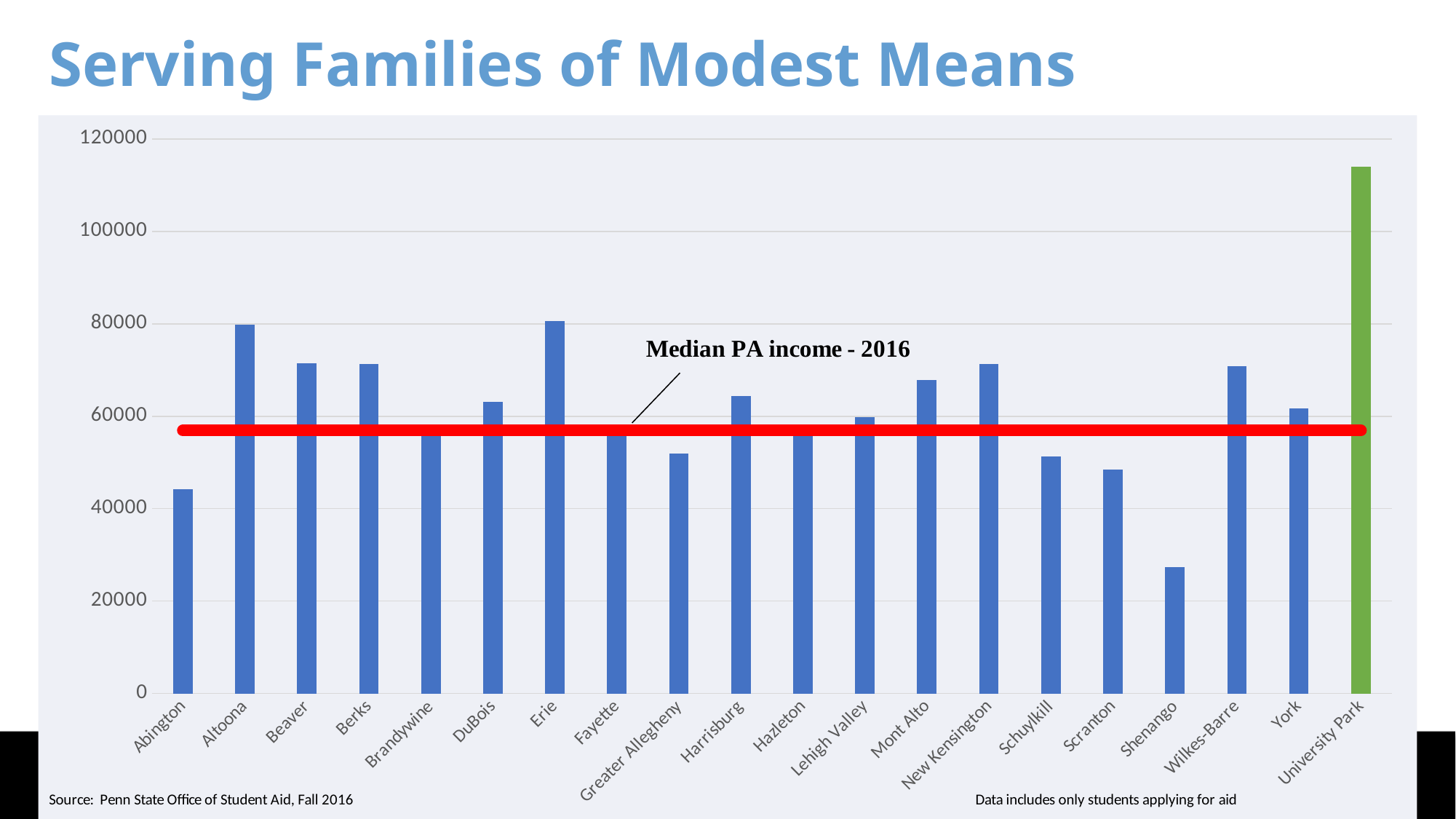
How many campuses are shown along the x axis of the chart? 20 Which campus has the highest bar in the chart? University Park Is the value for Wilkes-Barre greater or less than 60000? greater Is the value for Shenango greater or less than 40000? less Which has the larger value, Scranton or Shenango? Scranton Is the value for Greater Allegheny greater or less than 60000? less Which has the larger value, Erie or Abington? Erie What does the red horizontal line across the chart represent? Median PA income - 2016 Which campus has the lowest bar in the chart? Shenango What kind of chart is shown on the slide? bar chart